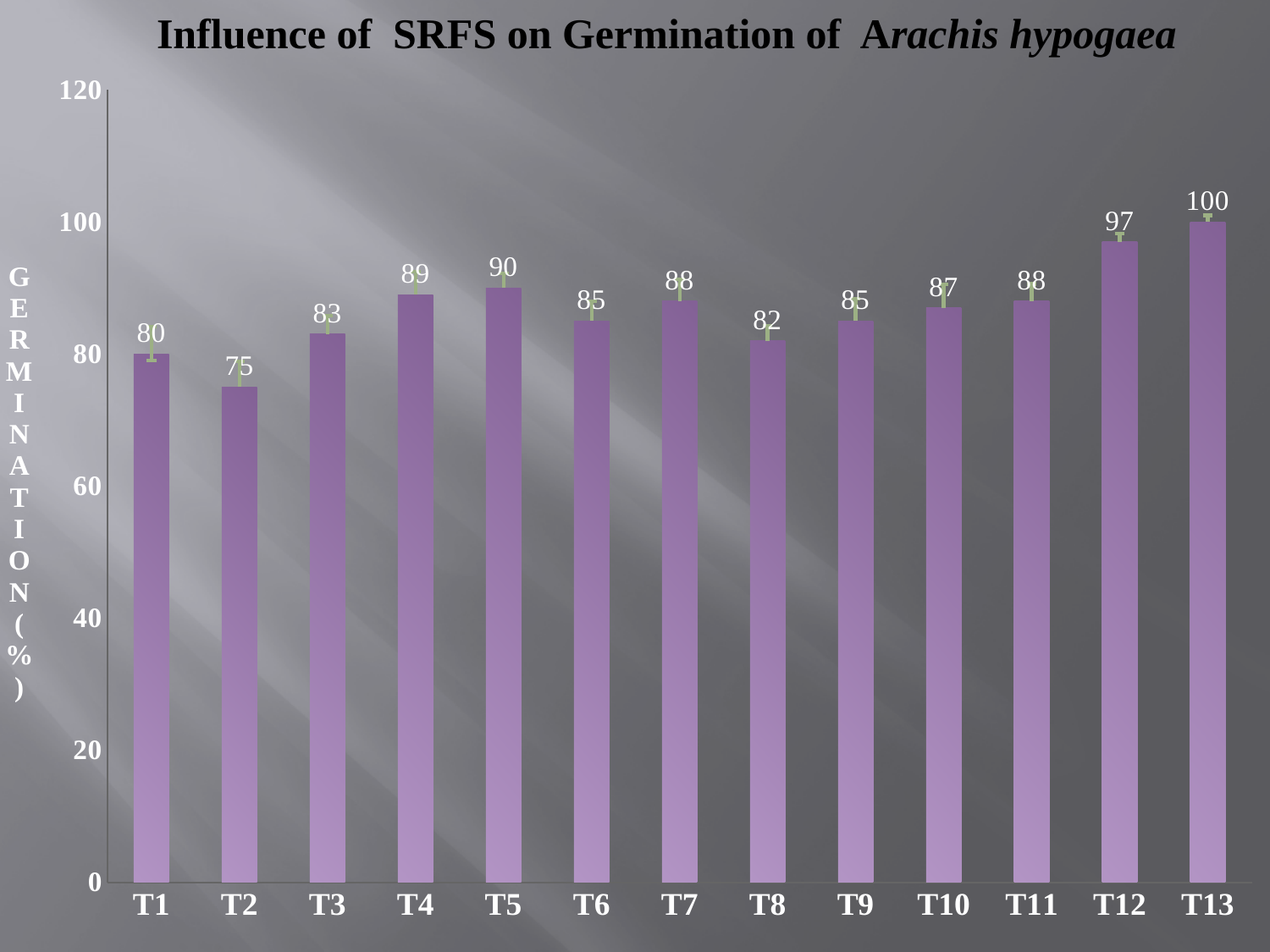
What is the germination value for T5? 90 What is the difference between the germination values for T12 and T8? 15 What is the germination value for T10? 87 Is the germination value for T12 greater or less than 80? greater What is the difference between the germination values for T13 and T1? 20 Which has a larger germination value, T4 or T6? T4 Which treatment has the lowest germination value? T2 How many treatments are shown on the x axis? 13 What kind of chart is shown on the slide? bar chart What is the title of the chart? Influence of SRFS on Germination of Arachis hypogaea What is the germination value for T2? 75 Which treatment has the highest germination value? T13